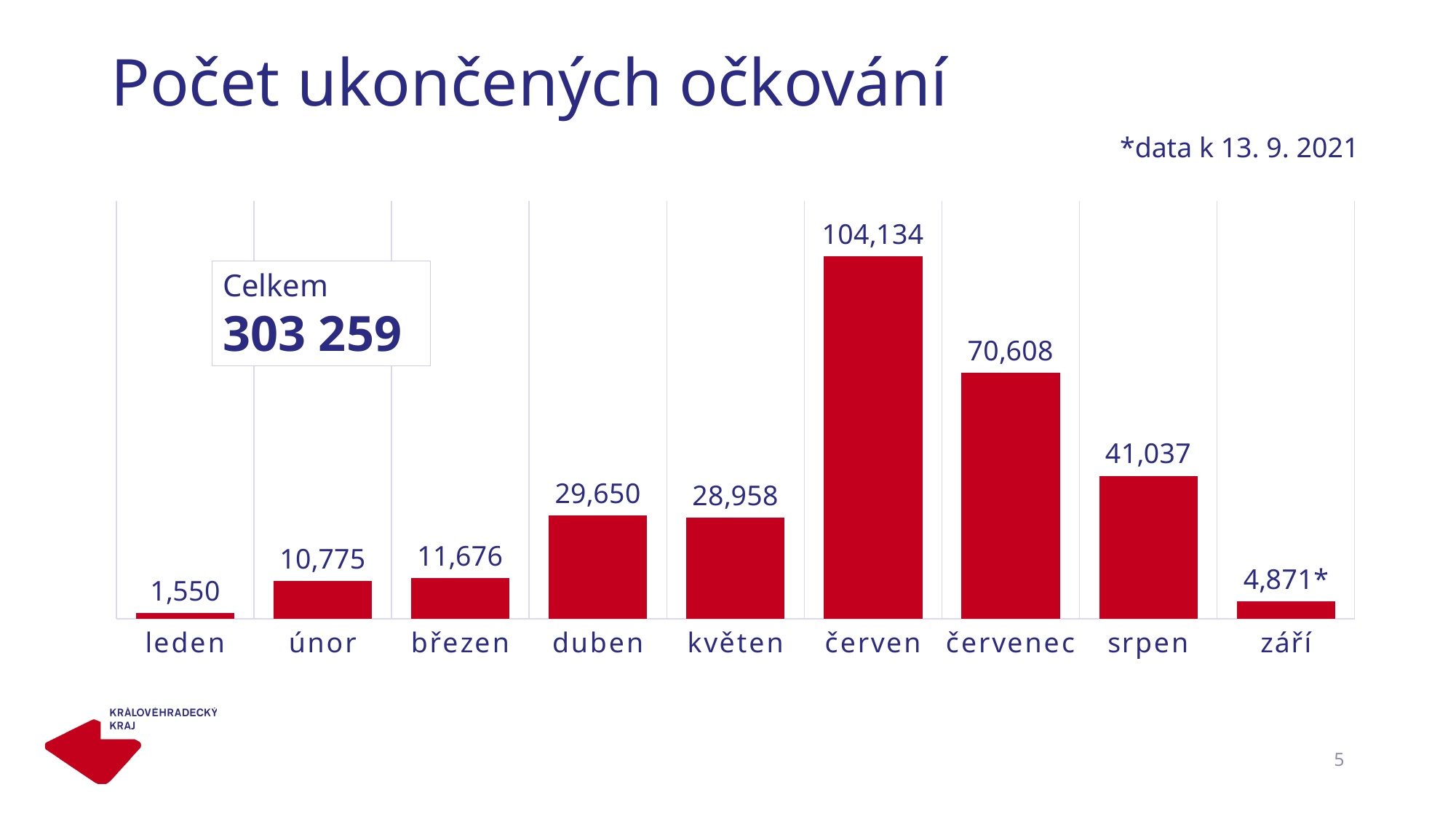
What is the difference between the values for srpen and září? 36,166 What kind of chart is shown on the slide? bar chart What is the difference between the values for červen and červenec? 33,526 What total (Celkem) is shown in the box on the chart? 303 259 What is the value for leden? 1,550 Which is larger, the value for duben or the value for květen? duben Which month has the highest value? červen What is the value for srpen? 41,037 How many months are shown on the x axis? 9 What is the value for červen? 104,134 Do the values rise or fall from leden to červen? rise Which month has the lowest value? leden